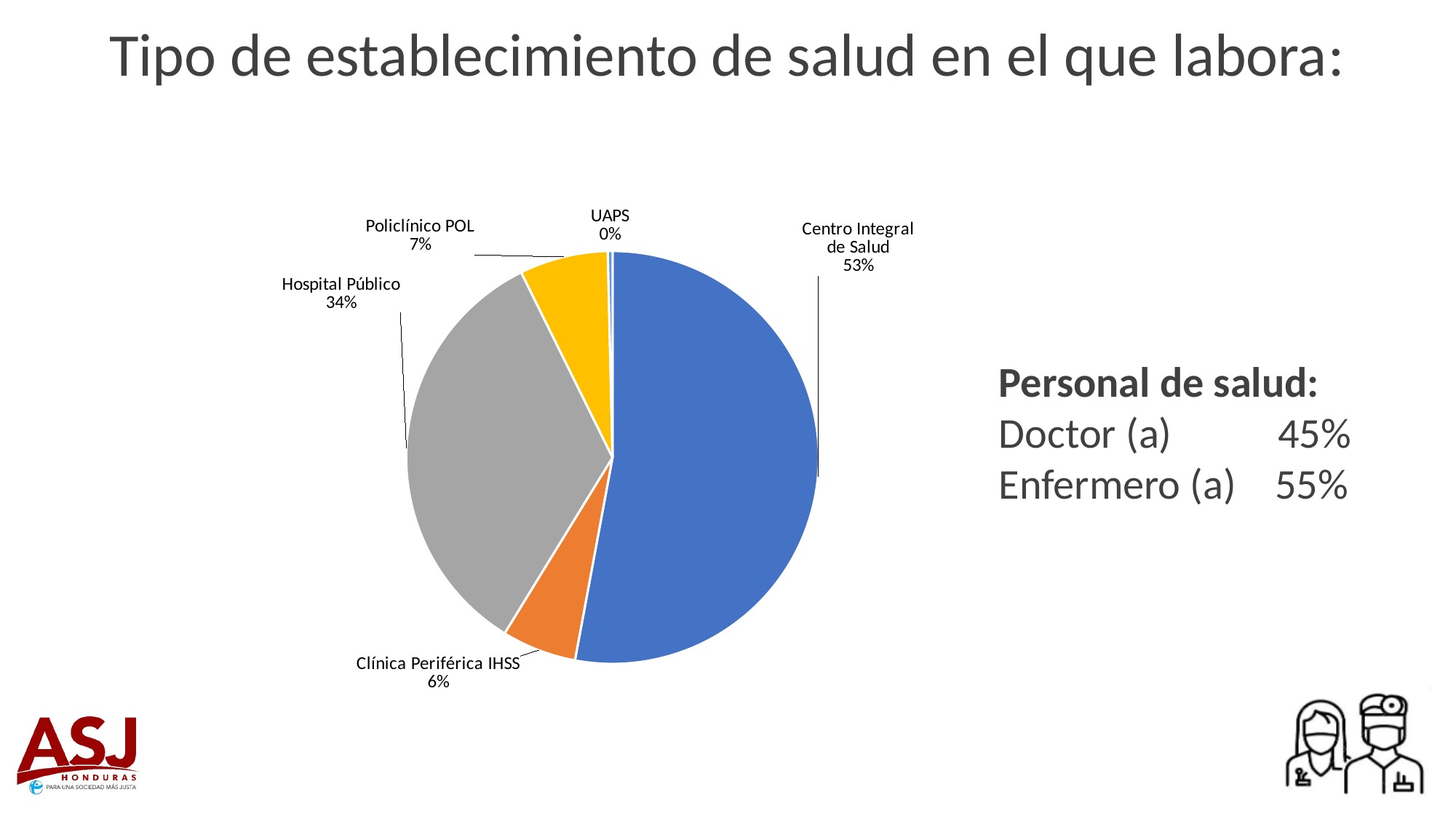
How many categories are shown in the pie chart? 5 What is the difference in percentage points between Centro Integral de Salud and Hospital Público? 19 Which category has the largest slice of the pie? Centro Integral de Salud What percentage is shown for Policlínico POL? 7% Which category has the smallest slice of the pie? UAPS What percentage is shown for Clínica Periférica IHSS? 6% Which is larger, the share for Policlínico POL or the share for Clínica Periférica IHSS? Policlínico POL What is the title of the slide containing the chart? Tipo de establecimiento de salud en el que labora: What share of the pie does Centro Integral de Salud represent? 53% What is the value shown for Hospital Público? 34% What percentage is shown for UAPS? 0% What kind of chart is shown on the slide? Pie chart